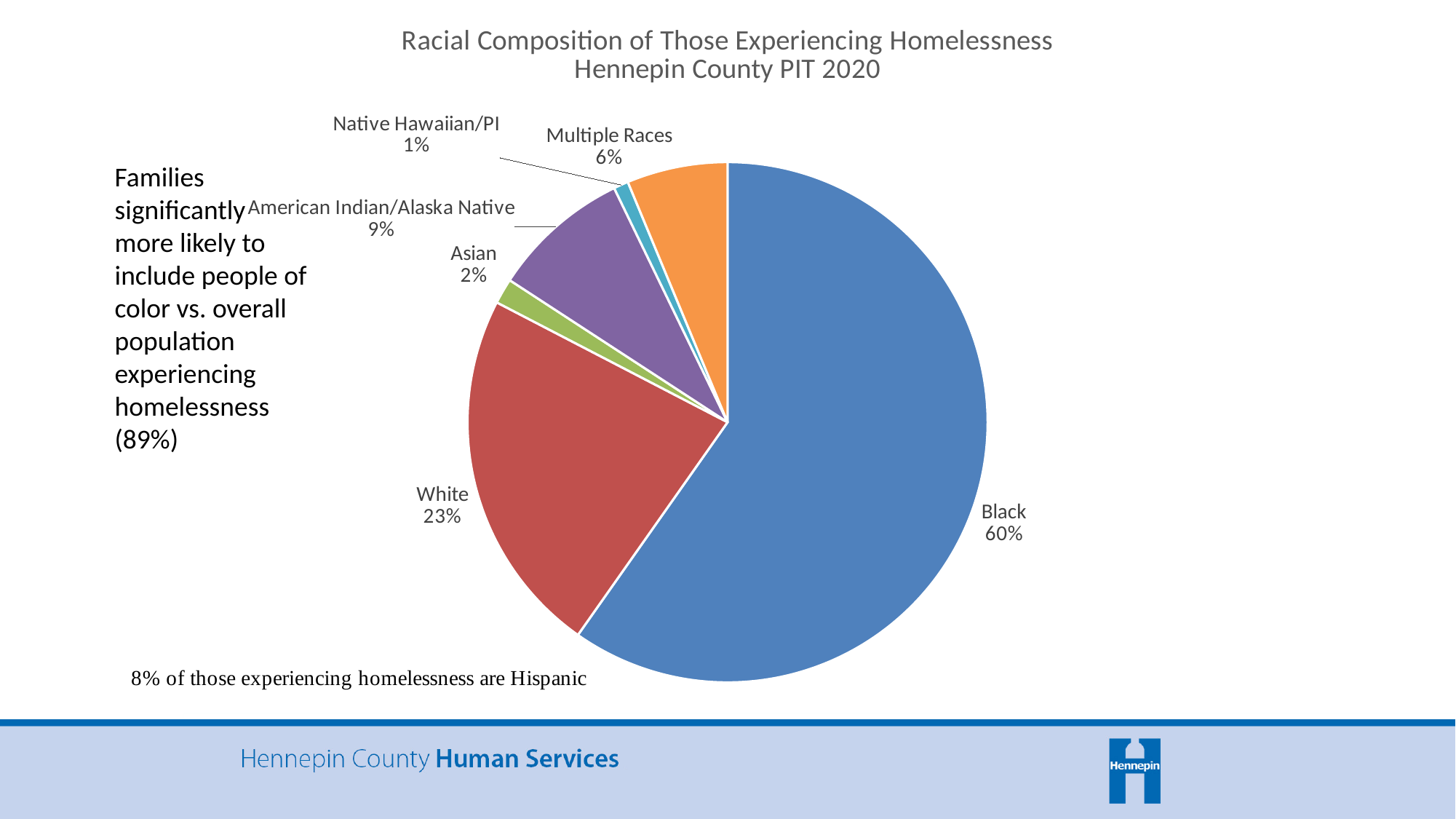
How many racial categories are shown in the pie chart? 6 Which racial group has the smallest slice of the pie? Native Hawaiian/PI What share of those experiencing homelessness is White? 23% Which racial group has the largest slice of the pie? Black Which slice is larger, American Indian/Alaska Native or Multiple Races? American Indian/Alaska Native What percentage is shown for American Indian/Alaska Native? 9% What type of chart is shown on the slide? Pie chart What share of those experiencing homelessness is Black? 60% What percentage is shown for Asian? 2% What is the title of the chart? Racial Composition of Those Experiencing Homelessness Hennepin County PIT 2020 What is the difference in percentage points between the Black and White slices? 37 What percentage is shown for Multiple Races? 6%